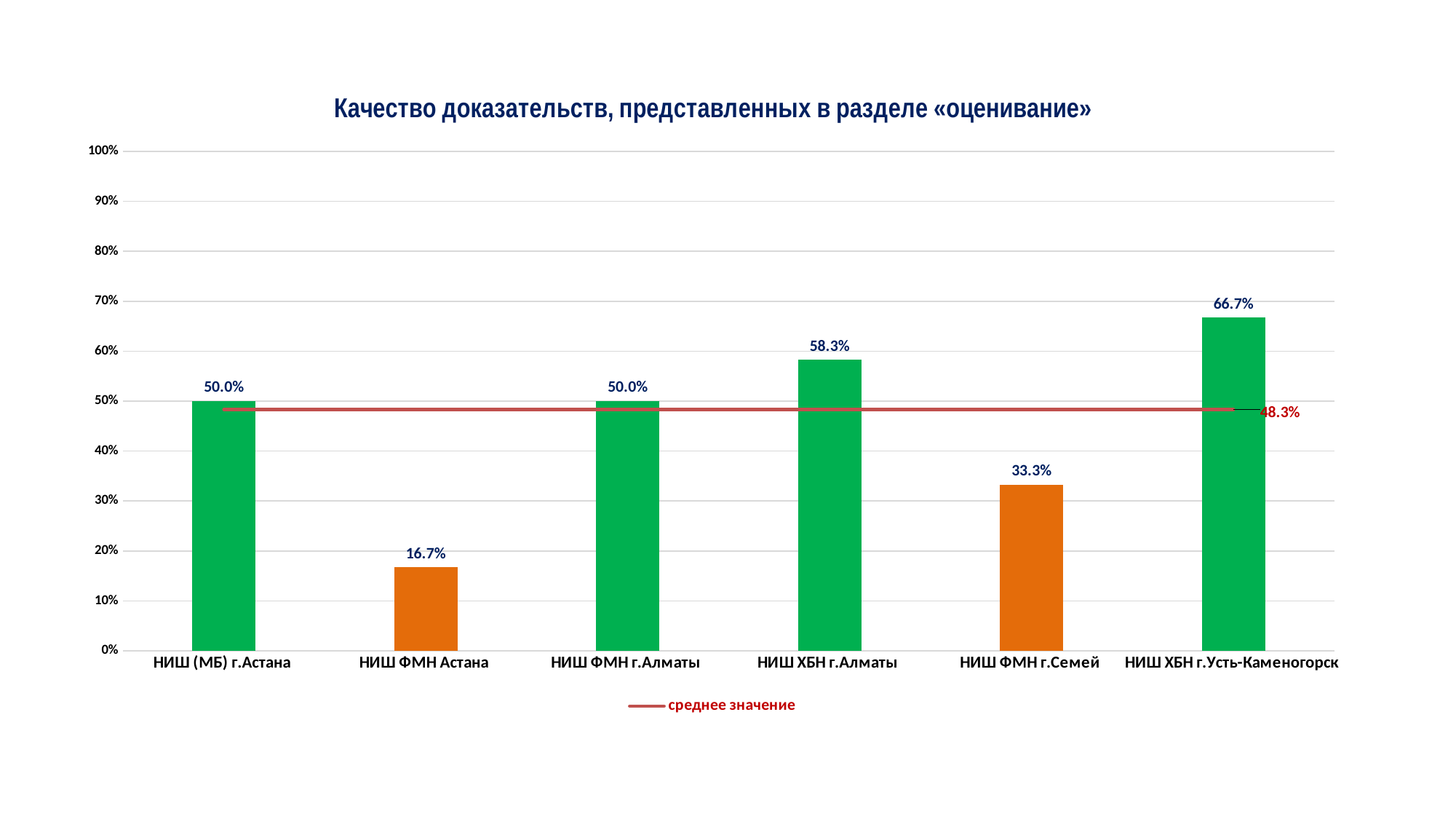
What is the value for НИШ ХБН г.Алматы? 58.3% What is the value for НИШ ФМН Астана? 16.7% What value is labelled on the red average line (среднее значение)? 48.3% What kind of chart is this? bar chart Which category has the lowest value? НИШ ФМН Астана How many categories are shown on the x axis? 6 Which category has the highest value? НИШ ХБН г.Усть-Каменогорск What is the value for НИШ ХБН г.Усть-Каменогорск? 66.7% What is the title of the chart? Качество доказательств, представленных в разделе «оценивание» Which is larger, the value for НИШ ХБН г.Алматы or the value for НИШ ФМН г.Семей? НИШ ХБН г.Алматы What is the difference between the values for НИШ ХБН г.Усть-Каменогорск and НИШ ФМН Астана? 50.0% What is the value for НИШ ФМН г.Семей? 33.3%